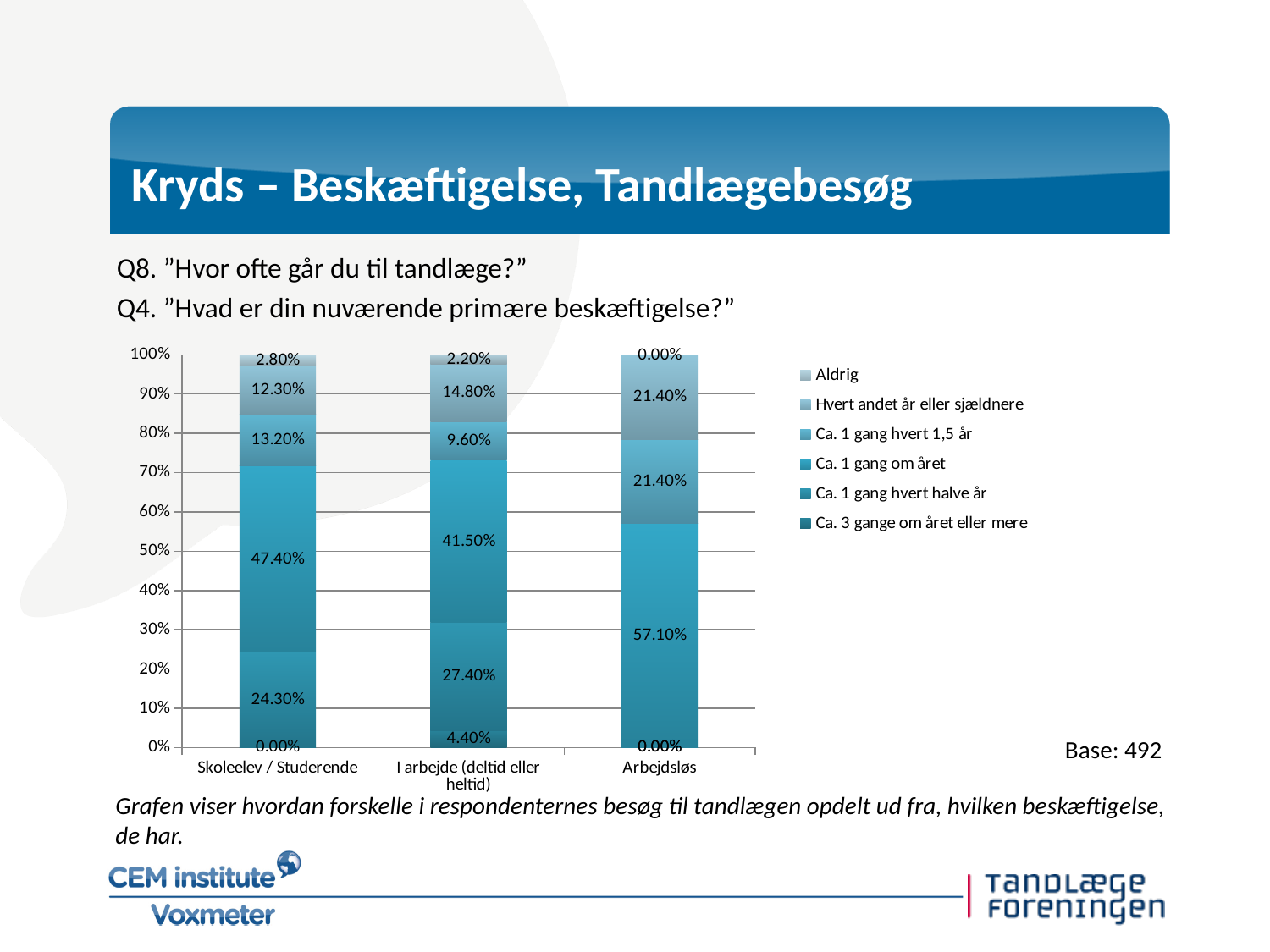
How many series does the chart's legend list? 6 Which category has the highest value for 'Ca. 1 gang hvert halve år'? I arbejde (deltid eller heltid) Which category has the larger value for 'Hvert andet år eller sjældnere': 'Skoleelev / Studerende' or 'I arbejde (deltid eller heltid)'? I arbejde (deltid eller heltid) What is the difference in percentage points between 'Ca. 1 gang hvert halve år' for 'I arbejde (deltid eller heltid)' (27.40%) and for 'Skoleelev / Studerende' (24.30%)? 3.10 percentage points What is the value for 'Aldrig' in the 'Skoleelev / Studerende' bar? 2.80% How many employment categories are shown on the x axis of the chart? 3 What kind of chart is shown on the slide? Stacked bar chart What is the value for 'Ca. 1 gang hvert halve år' in the 'Arbejdsløs' bar? 0.00% What is the value for 'Ca. 3 gange om året eller mere' in the 'I arbejde (deltid eller heltid)' bar? 4.40% What is the value for 'Ca. 1 gang om året' in the 'I arbejde (deltid eller heltid)' bar? 41.50% What is the value for 'Ca. 1 gang om året' in the 'Skoleelev / Studerende' bar? 47.40% What is the value for 'Ca. 1 gang hvert 1,5 år' in the 'I arbejde (deltid eller heltid)' bar? 9.60%